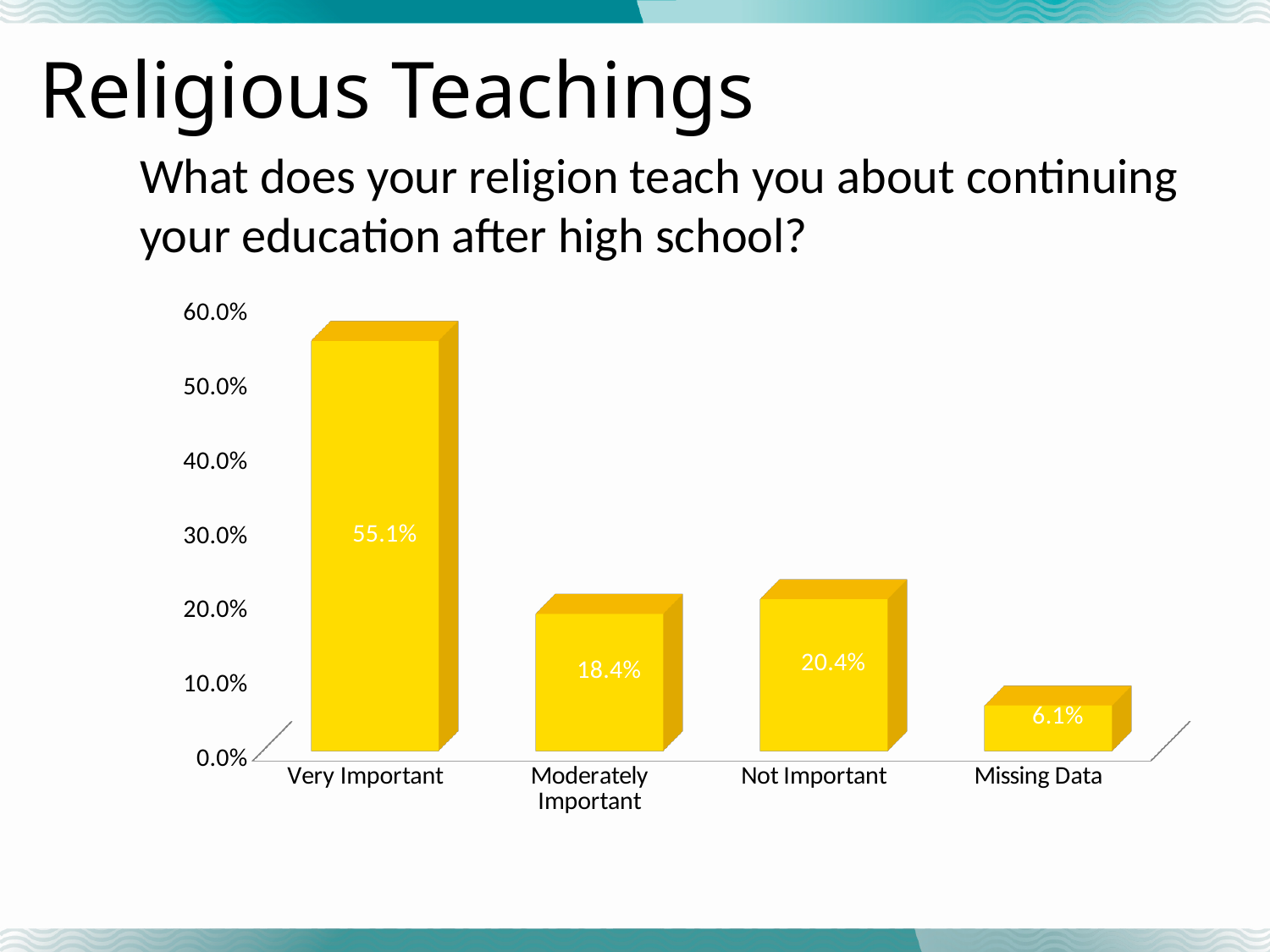
What is the value for Not Important? 20.4% Which category has the lowest value? Missing Data What is the difference between the values for Very Important and Not Important? 34.7% Which category has the highest value? Very Important Which is larger, the value for Not Important or the value for Moderately Important? Not Important How many categories are shown on the x axis? 4 What kind of chart is shown on the slide? bar chart What colour are the bars in the chart? yellow What is the value for Missing Data? 6.1% Is the value for Very Important greater or less than 50.0%? greater What is the value for Very Important? 55.1% What is the value for Moderately Important? 18.4%